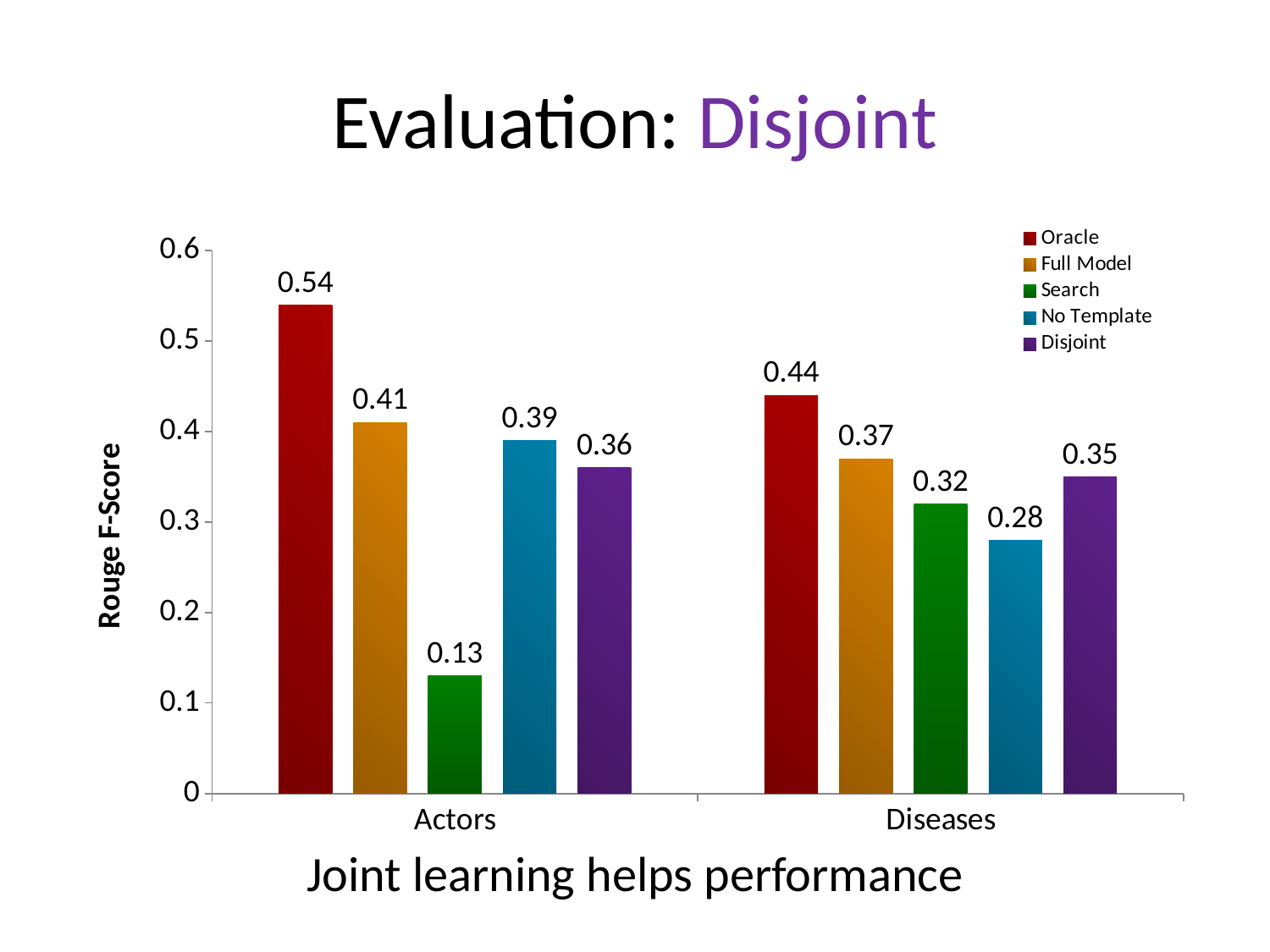
Which series has the highest value for Actors? Oracle What is the label of the y axis? Rouge F-Score How many categories are shown on the x axis? 2 What is the Rouge F-Score for Search on Actors? 0.13 What kind of chart is shown on the slide? Bar chart How many series does the legend list? 5 What is the difference between the Oracle and Full Model values for Diseases? 0.07 Which series has the lowest value for Diseases? No Template Is the Full Model value for Actors greater or less than 0.4? greater What is the Rouge F-Score for Disjoint on Diseases? 0.35 What is the Rouge F-Score for Oracle on Actors? 0.54 Which is larger: the No Template value for Actors or the No Template value for Diseases? Actors